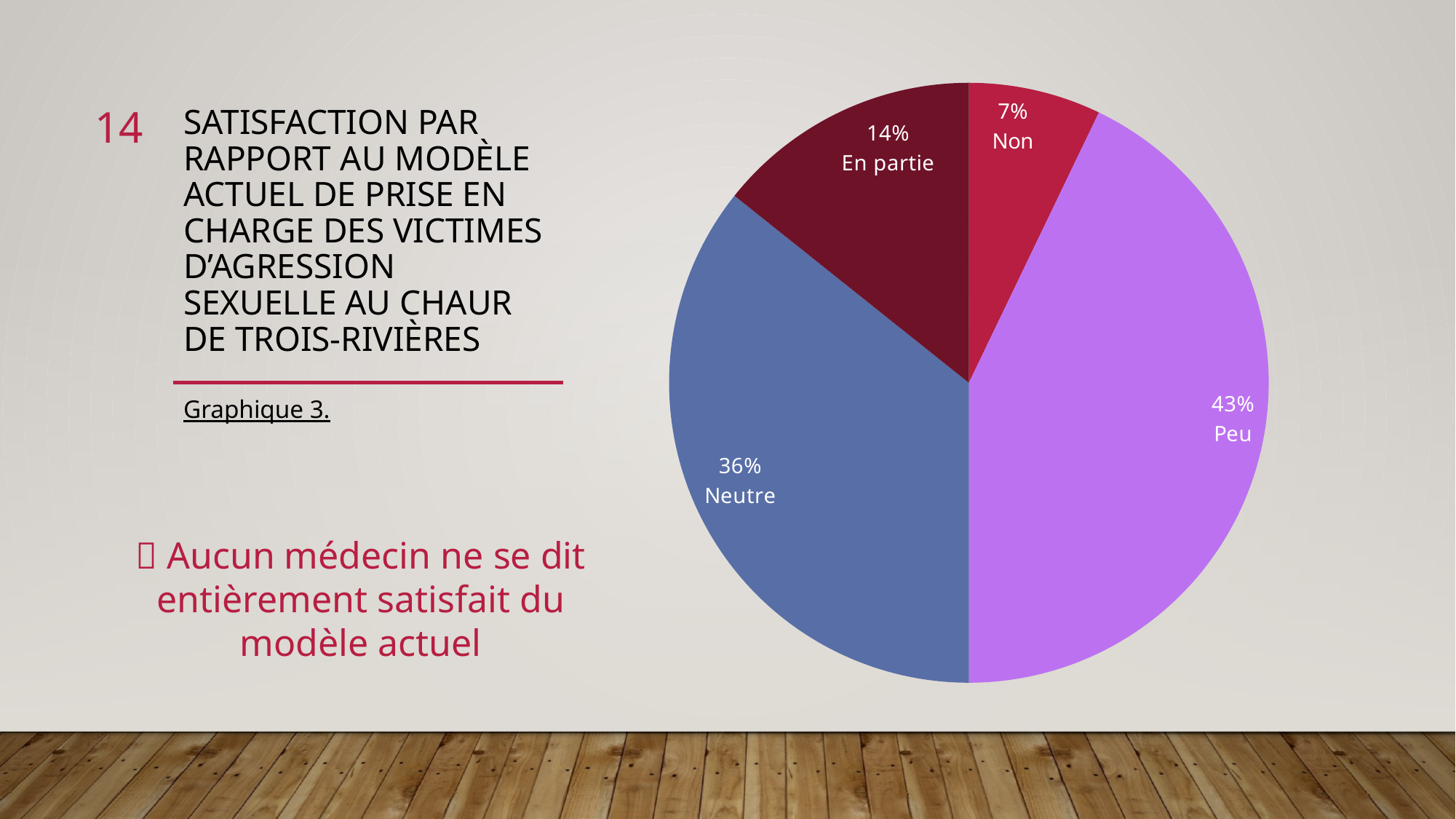
What percentage of the pie is labelled "Non"? 7% Which slice is larger, "En partie" or "Non"? En partie How many slices does the pie chart have? 4 What kind of chart is shown on the slide? pie chart What is the combined share of the "En partie" and "Non" slices? 21% Which slice of the pie is the largest? Peu What is the difference in percentage points between the "Peu" slice and the "Neutre" slice? 7 What colour is the "Neutre" slice of the pie? blue What percentage of the pie is labelled "Peu"? 43% Which slice of the pie is the smallest? Non What percentage of the pie is labelled "En partie"? 14% What percentage of the pie is labelled "Neutre"? 36%